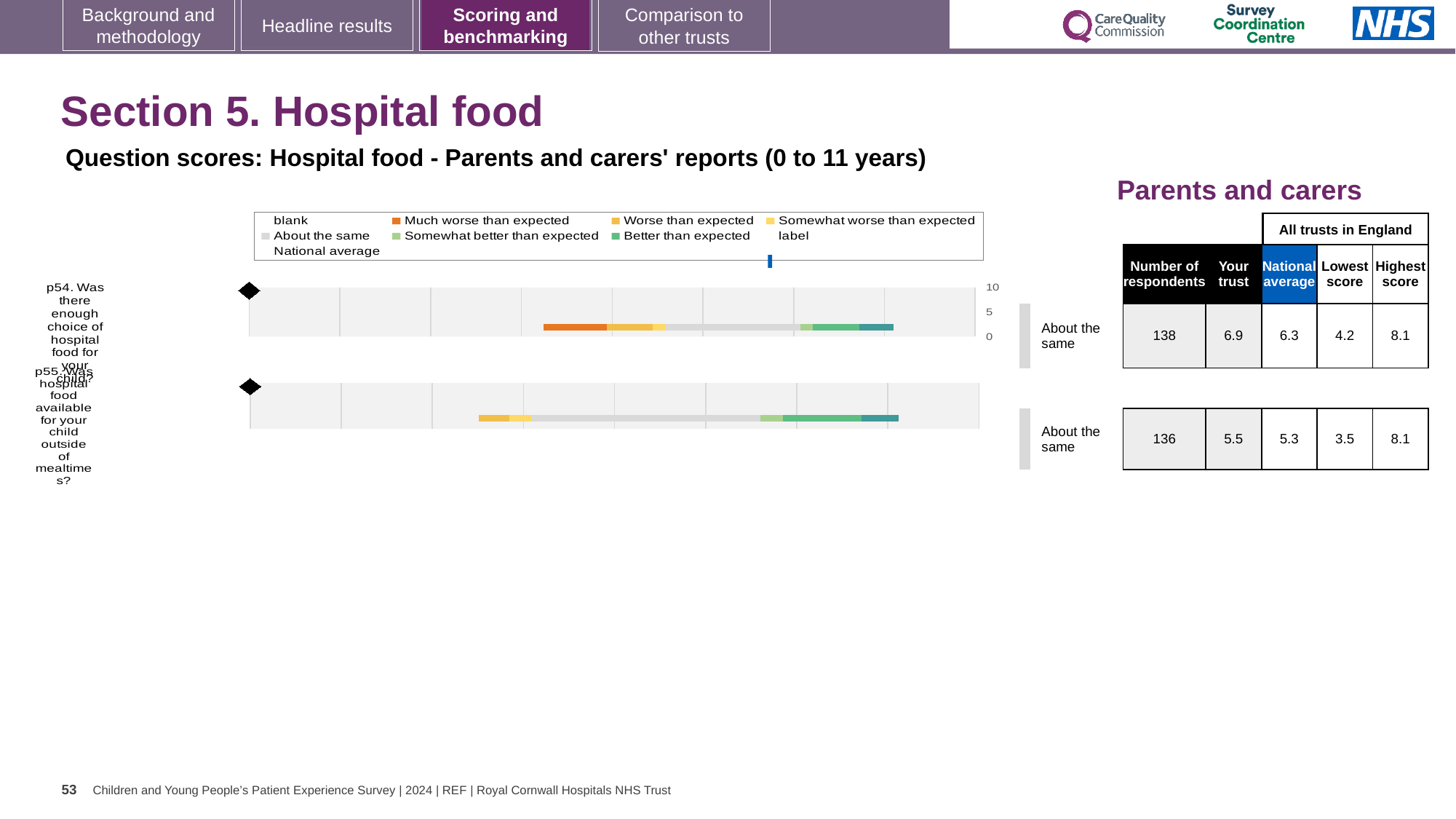
How many questions (categories) are plotted in the hospital food chart? 2 How many entries does the legend of the hospital food chart list? 9 In the table next to the chart, how many respondents answered p54? 138 What kind of chart is used to show the question scores for hospital food? bar chart What is the maximum value shown on the score axis of the hospital food chart? 10 In the table next to the chart, what is the national average for p55 (hospital food available outside of mealtimes)? 5.3 What is the difference between the 'Your trust' scores for p54 and p55? 1.4 In the table next to the chart, what is the lowest score across all trusts in England for p55? 3.5 What is the difference between the 'Your trust' score and the national average for p54? 0.6 Which question has the higher 'Your trust' score, p54 or p55? p54 In the table next to the chart, what is the 'Your trust' score for p54 (enough choice of hospital food)? 6.9 Which legend entry in the hospital food chart is shown in orange? Much worse than expected